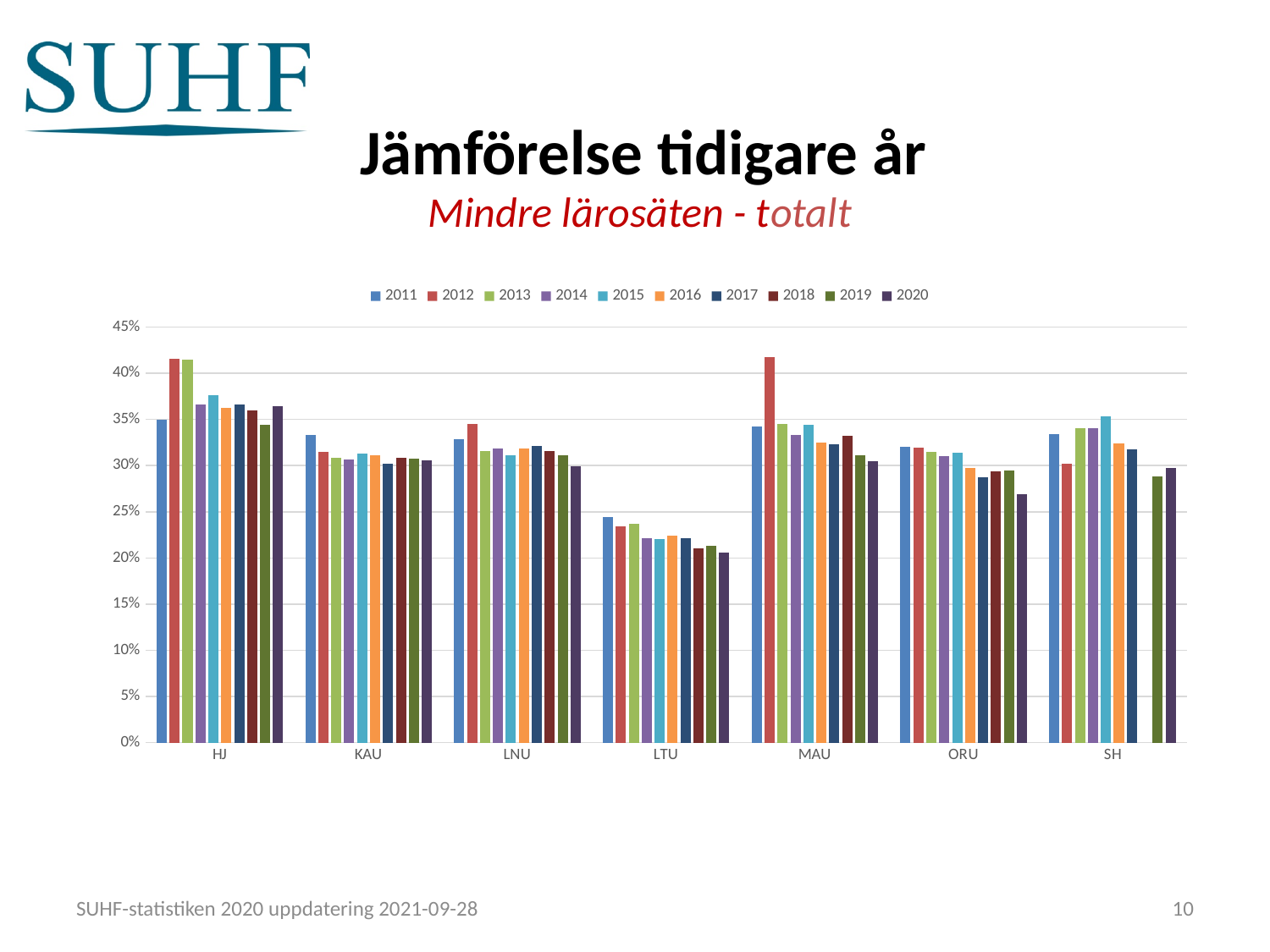
How many categories (institutions) are shown on the x axis? 7 Which years does the legend cover? 2011 to 2020 Is the value for LTU in 2011 greater or less than 20%? greater Is the value for ORU in 2020 greater or less than 30%? less Which year has the lowest value for ORU? 2020 Which institution has the lowest values overall across the years? LTU Is the value for MAU in 2012 greater or less than 40%? greater How many series does the legend list? 10 Which year has the highest value for MAU? 2012 What is the main title of the slide? Jämförelse tidigare år What kind of chart is shown on the slide? bar chart